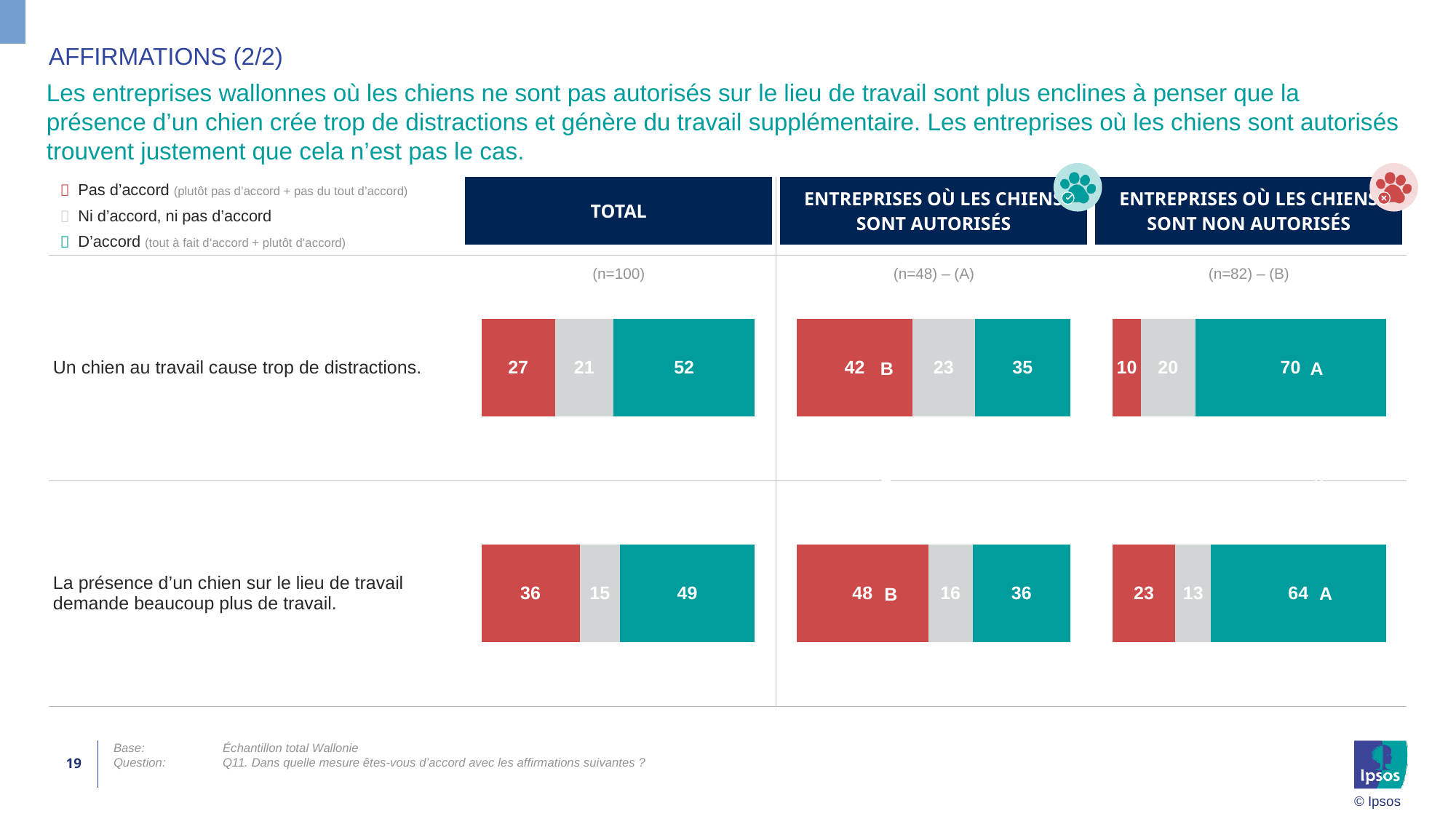
In the ENTREPRISES OÙ LES CHIENS SONT AUTORISÉS column, which segment is the largest for 'La présence d'un chien sur le lieu de travail demande beaucoup plus de travail.'? Pas d'accord In the TOTAL column, what is the 'Ni d'accord, ni pas d'accord' value for 'La présence d'un chien sur le lieu de travail demande beaucoup plus de travail.'? 15 In the TOTAL column, what is the total of the stacked bar for 'Un chien au travail cause trop de distractions.'? 100 How many series does the legend list? 3 In the ENTREPRISES OÙ LES CHIENS SONT NON AUTORISÉS column, what is the 'Pas d'accord' value for 'Un chien au travail cause trop de distractions.'? 10 What is the sample size (n) shown for the ENTREPRISES OÙ LES CHIENS SONT NON AUTORISÉS column? n=82 In the TOTAL column, what is the 'D'accord' value for 'Un chien au travail cause trop de distractions.'? 52 For 'La présence d'un chien sur le lieu de travail demande beaucoup plus de travail.', which column has the larger 'Pas d'accord' value: ENTREPRISES OÙ LES CHIENS SONT AUTORISÉS or ENTREPRISES OÙ LES CHIENS SONT NON AUTORISÉS? ENTREPRISES OÙ LES CHIENS SONT AUTORISÉS In the ENTREPRISES OÙ LES CHIENS SONT AUTORISÉS column, what is the 'Pas d'accord' value for 'Un chien au travail cause trop de distractions.'? 42 For 'Un chien au travail cause trop de distractions.', what is the difference between the 'D'accord' value in the ENTREPRISES OÙ LES CHIENS SONT NON AUTORISÉS column and the ENTREPRISES OÙ LES CHIENS SONT AUTORISÉS column? 35 In the ENTREPRISES OÙ LES CHIENS SONT NON AUTORISÉS column, what is the 'D'accord' value for 'La présence d'un chien sur le lieu de travail demande beaucoup plus de travail.'? 64 What kind of chart is used on this slide? Stacked bar chart